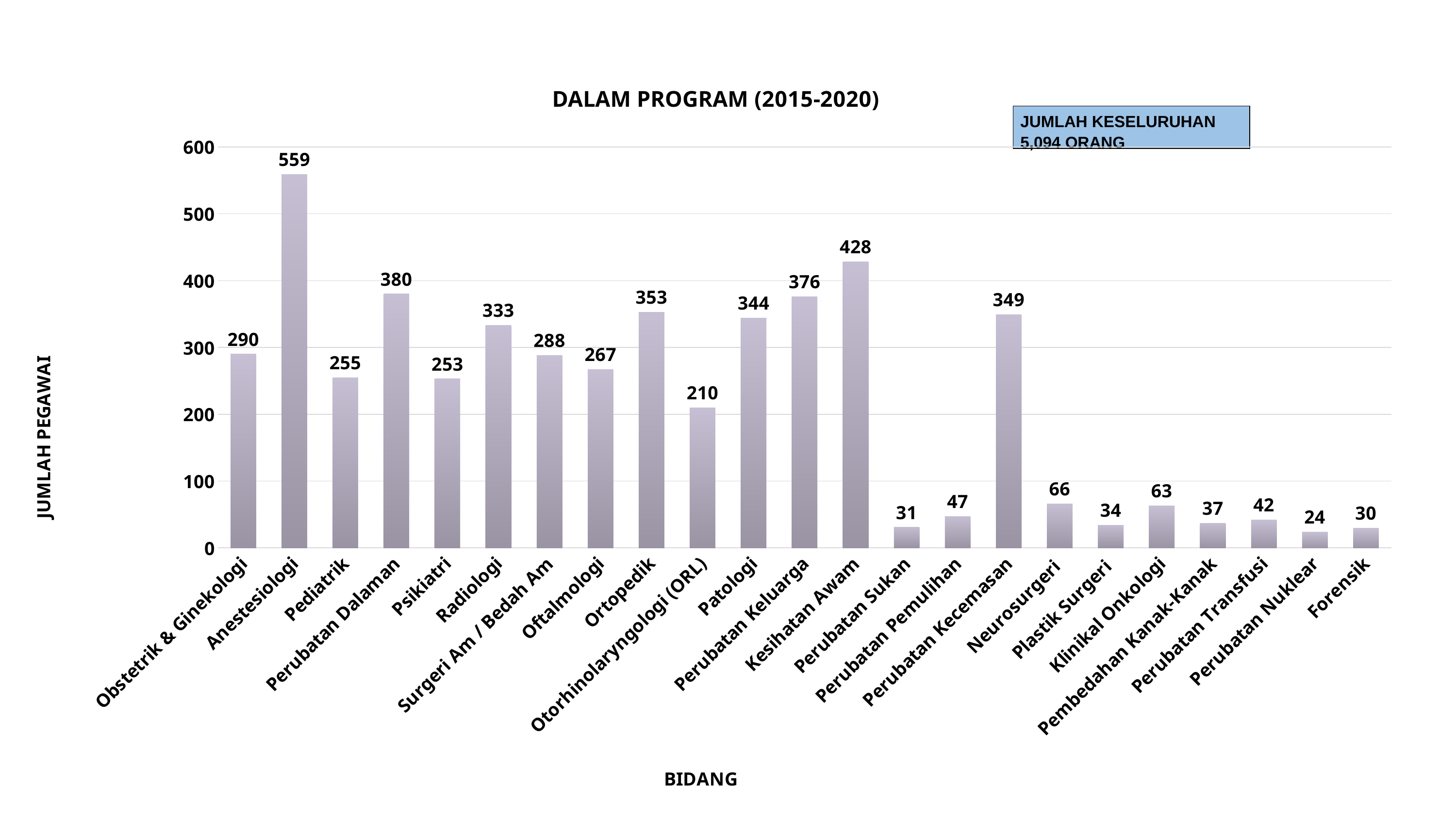
What kind of chart is this? bar chart What is the title of the chart? DALAM PROGRAM (2015-2020) What is the label of the y axis? JUMLAH PEGAWAI What is the difference between the values for Perubatan Dalaman and Pediatrik? 125 What is the value for Kesihatan Awam? 428 How many categories are shown on the x axis? 23 What is the value for Perubatan Nuklear? 24 Which category has the lowest value? Perubatan Nuklear Is the value for Perubatan Kecemasan greater or less than 300? greater Which category has the highest value? Anestesiologi Which is larger, the value for Ortopedik or the value for Patologi? Ortopedik What is the value for Anestesiologi? 559